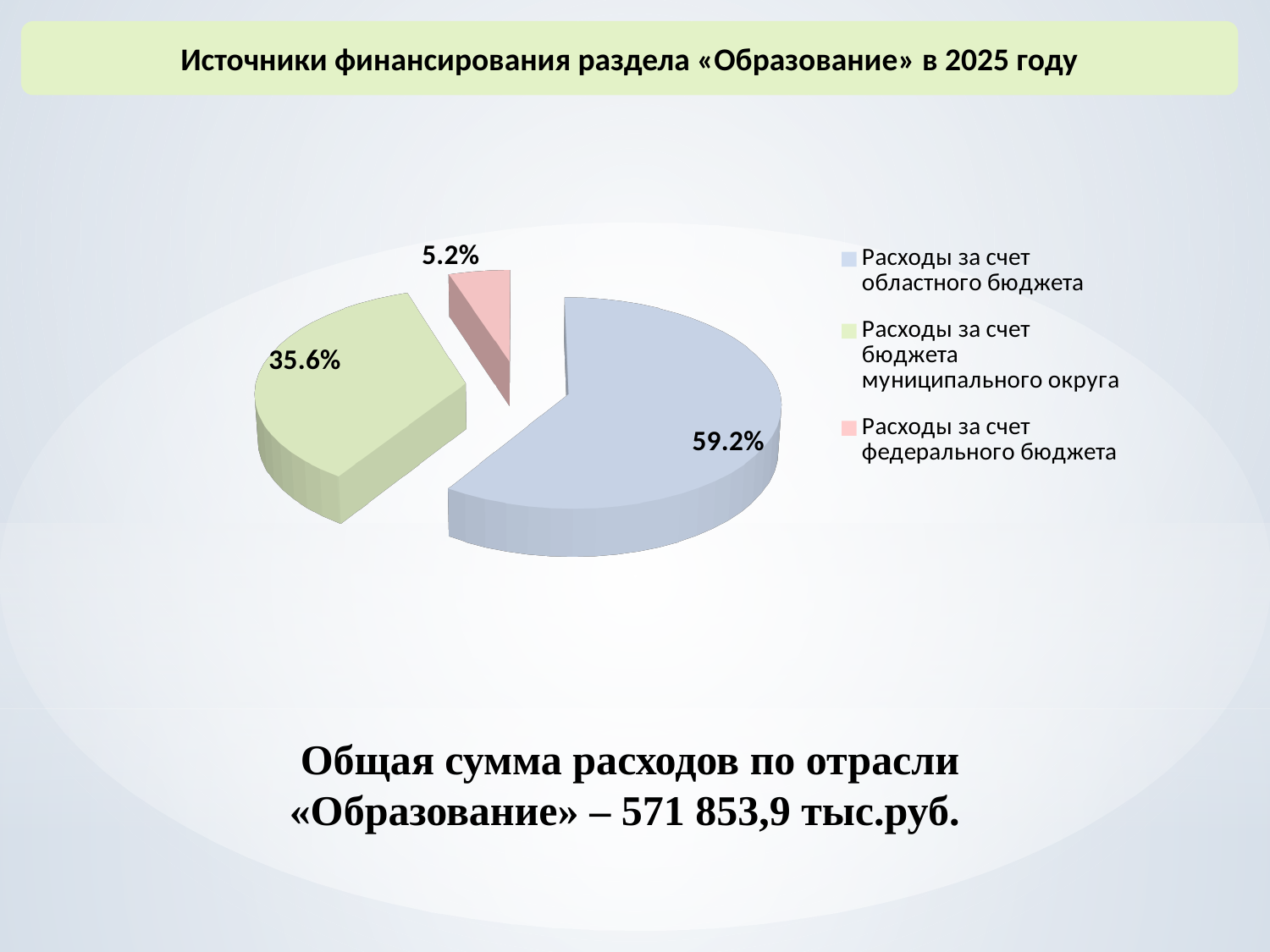
How many slices does the pie chart have? 3 What type of chart is shown on the slide? Pie chart Which is larger: the slice for the municipal district budget or the slice for the federal budget? Расходы за счет бюджета муниципального округа Which funding source has the smallest slice of the pie? Расходы за счет федерального бюджета What share of the pie is labelled for 'Расходы за счет федерального бюджета'? 5.2% What colour is the slice for 'Расходы за счет федерального бюджета'? Pink What share of the pie is labelled for 'Расходы за счет областного бюджета'? 59.2% What is the difference in percentage points between the regional budget slice (59.2%) and the municipal district budget slice (35.6%)? 23.6 What is the title of the chart on the slide? Источники финансирования раздела «Образование» в 2025 году How many entries does the legend list? 3 Which funding source has the largest slice of the pie? Расходы за счет областного бюджета What share of the pie is labelled for 'Расходы за счет бюджета муниципального округа'? 35.6%